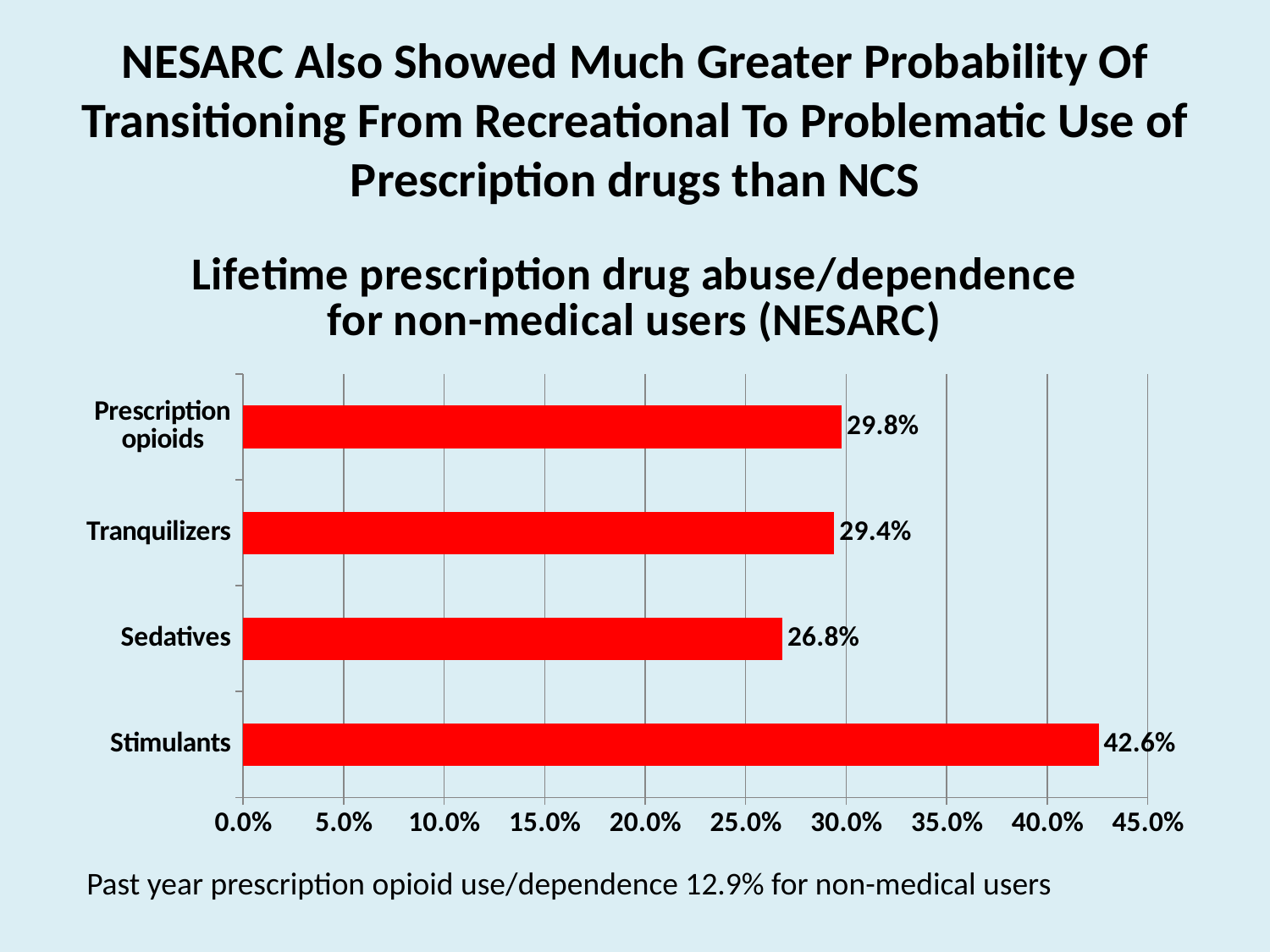
What is the difference between the values for Prescription opioids and Tranquilizers? 0.4% What is the value for Sedatives? 26.8% Which is larger, the value for Stimulants or the value for Prescription opioids? Stimulants What kind of chart is shown on the slide? Bar chart What is the value for Tranquilizers? 29.4% Which category has the highest value? Stimulants Is the value for Sedatives greater or less than 30.0%? less What is the value for Stimulants? 42.6% Which category has the lowest value? Sedatives How many categories are shown in the chart? 4 What is the difference between the values for Stimulants and Sedatives? 15.8% What is the value for Prescription opioids? 29.8%